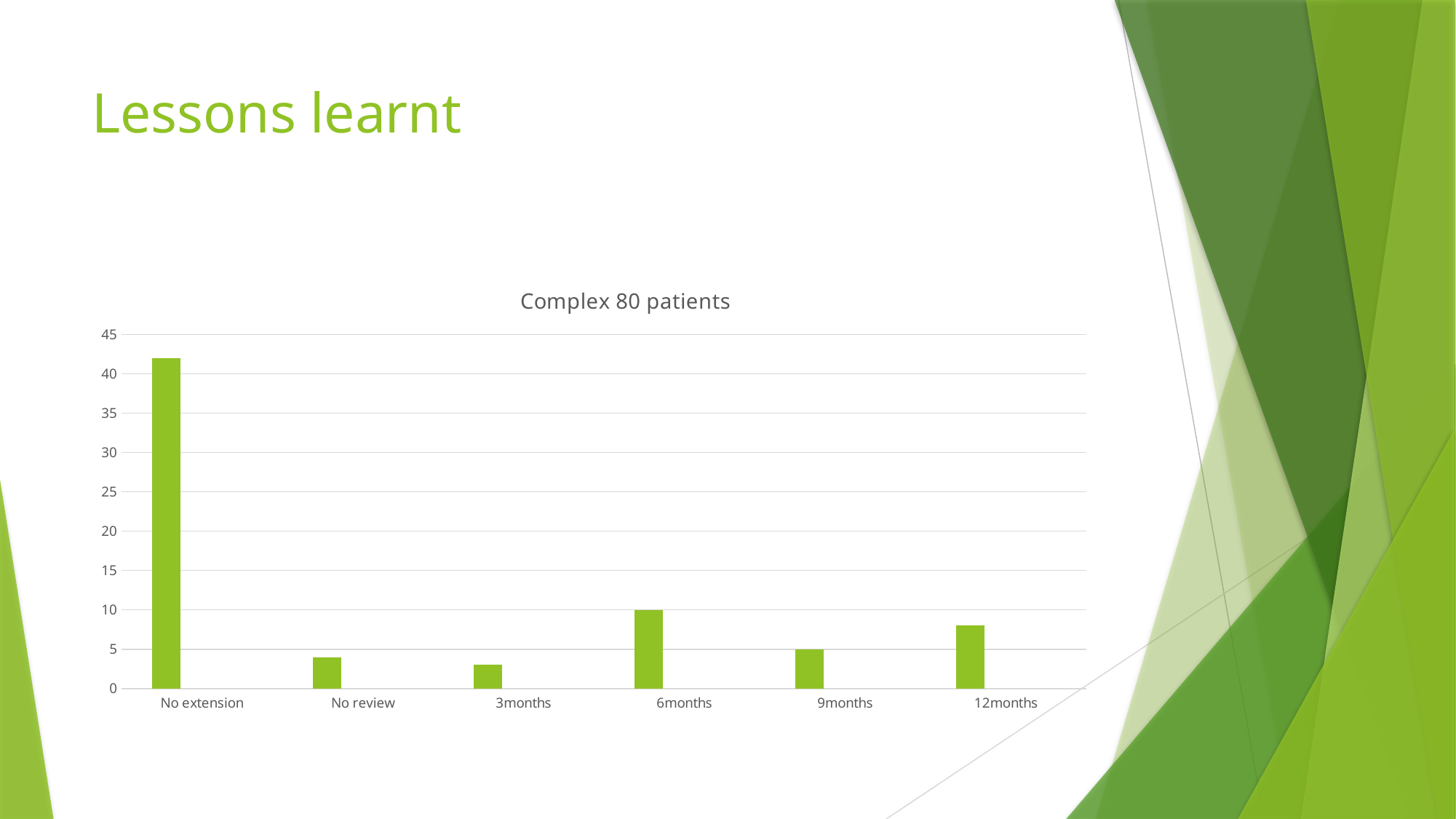
How many categories are shown on the x axis of the chart? 6 Which category has the highest value in the chart? No extension Which is larger, the value for 6months or the value for 12months? 6months Which is larger, the value for No extension or the value for 6months? No extension What is the value for 9months? 5 What kind of chart is shown on the slide? bar chart What is the difference between the values for 6months and 9months? 5 What is the value for 6months? 10 Is the value for No extension greater or less than 40? greater Is the value for 12months greater or less than 10? less What is the title of the chart? Complex 80 patients Is the value for No review greater or less than 5? less